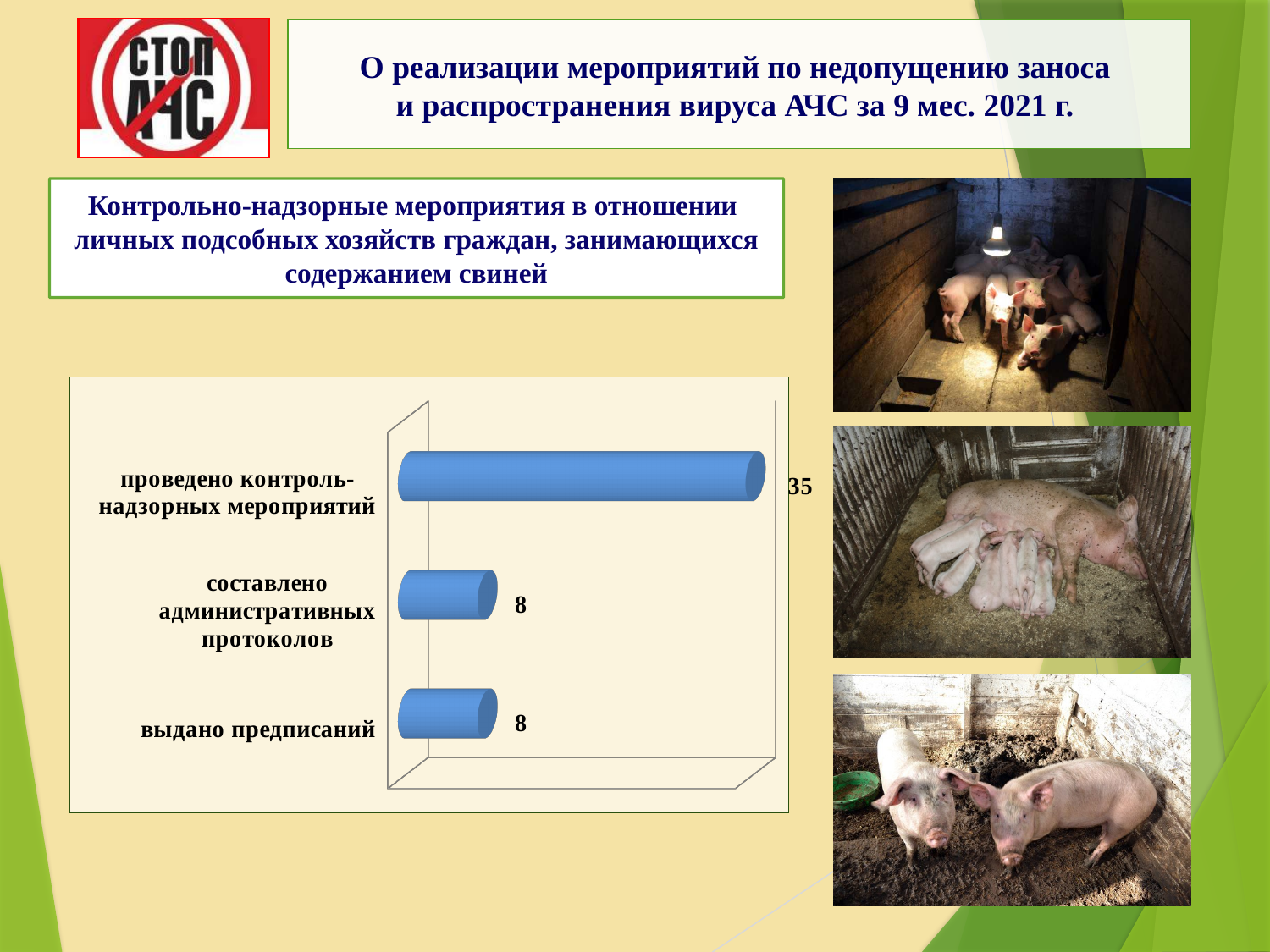
What value is shown for "составлено административных протоколов"? 8 What value is shown for "проведено контроль-надзорных мероприятий"? 35 What value is shown for "выдано предписаний"? 8 How many categories are shown in the chart? 3 Which category has the highest value? проведено контроль-надзорных мероприятий What colour are the bars in the chart? blue What is the difference between the value for "проведено контроль-надзорных мероприятий" and the value for "составлено административных протоколов"? 27 What is the total of the three values shown in the chart? 51 Which is larger: the value for "проведено контроль-надзорных мероприятий" or the value for "выдано предписаний"? проведено контроль-надзорных мероприятий What kind of chart is shown on the slide? bar chart Do the values for "составлено административных протоколов" and "выдано предписаний" differ? No, both are 8 What is the heading of the text box above the chart? Контрольно-надзорные мероприятия в отношении личных подсобных хозяйств граждан, занимающихся содержанием свиней